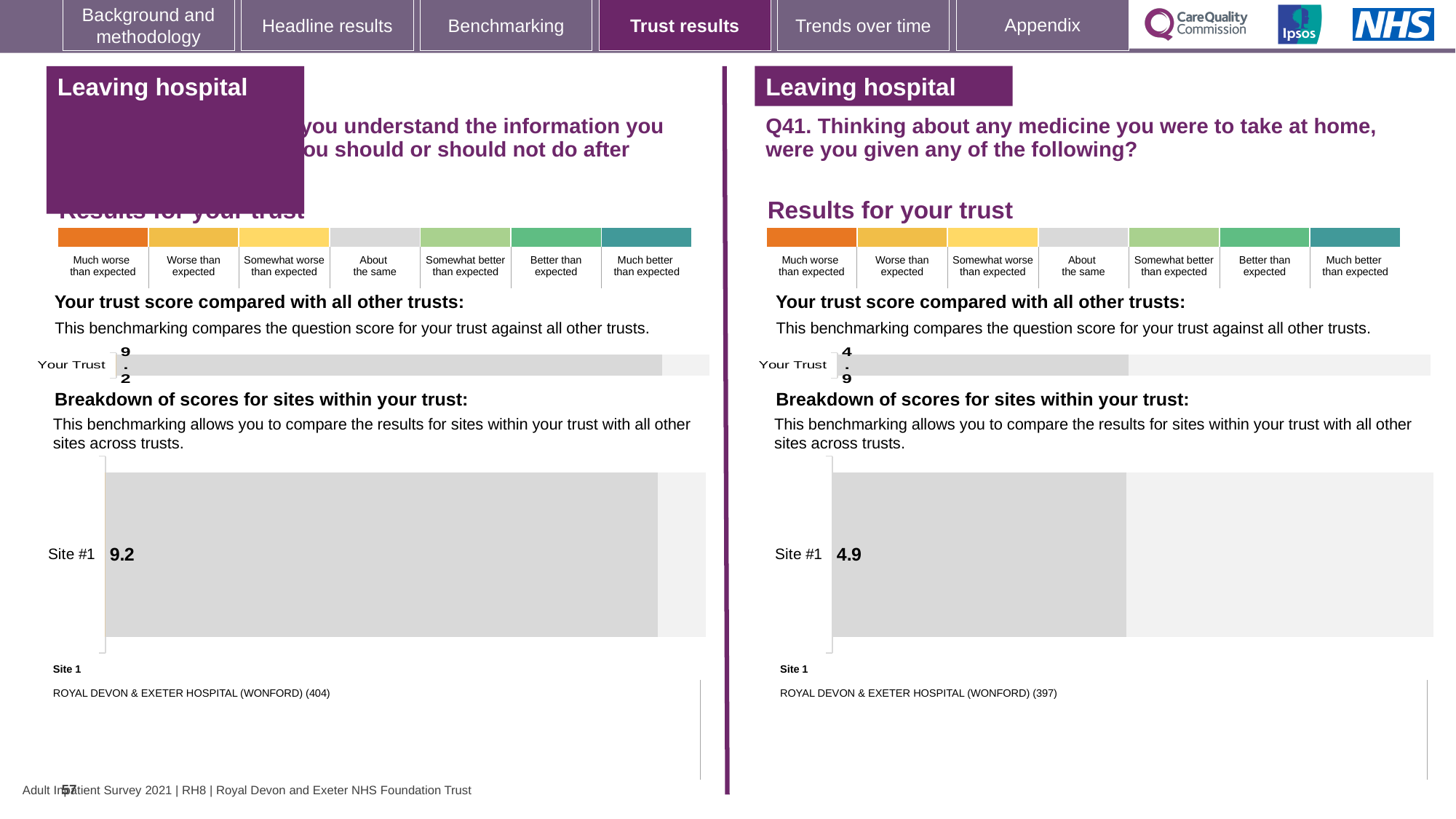
On the right-hand panel (Q41), what is the score shown for Your Trust? 4.9 On the left-hand panel, what is the score shown for Site #1 in the breakdown of scores for sites? 9.2 On the right-hand panel (Q41), is the Your Trust score of 4.9 equal to the Site #1 score? Yes How many sites are shown in the breakdown of scores for sites on the right-hand panel (Q41)? 1 What kind of chart is used to show the Site #1 score on the right-hand panel (Q41)? Bar chart On the right-hand panel (Q41), what is the score shown for Site #1 in the breakdown of scores for sites? 4.9 Which panel shows the higher Site #1 score, the left-hand panel or the right-hand panel (Q41)? Left-hand panel On the right-hand panel (Q41), what number is shown in brackets after the Site 1 hospital name? 397 On the left-hand panel, what is the score shown for Your Trust? 9.2 What is the difference between the Your Trust score on the left-hand panel and the Your Trust score on the right-hand panel (Q41)? 4.3 Which panel shows the higher Your Trust score, the left-hand panel or the right-hand panel (Q41)? Left-hand panel On the right-hand panel (Q41), which hospital is listed as Site 1? ROYAL DEVON & EXETER HOSPITAL (WONFORD)